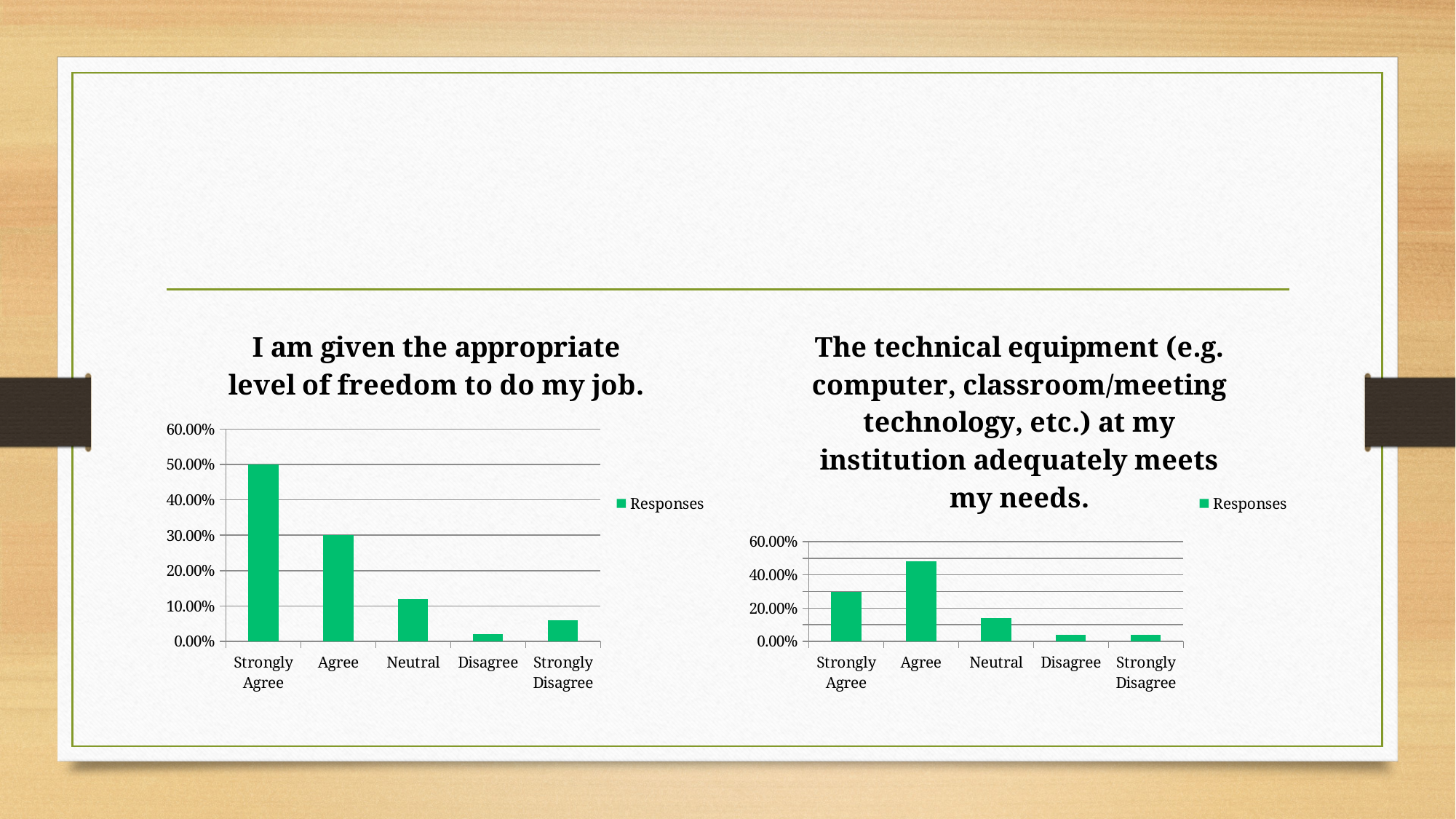
In the left chart, what is the difference between the Strongly Agree and Agree values? 20.00% In the left chart, which category has the lowest value? Disagree In the chart about technical equipment, is the value for Agree greater or less than 40.00%? greater How many categories are shown on the x axis of the left chart? 5 In the chart about technical equipment, which category has the highest value? Agree In the right chart, which is larger, the value for Strongly Agree or the value for Agree? Agree In the chart about technical equipment, is the value for Neutral greater or less than 20.00%? less In the chart titled "I am given the appropriate level of freedom to do my job.", what is the value for Strongly Agree? 50.00% In the chart titled "I am given the appropriate level of freedom to do my job.", what is the value for Agree? 30.00% In the left chart, is the value for Neutral greater or less than 20.00%? less In the left chart, which category has the highest value? Strongly Agree What type of chart is the chart about technical equipment? Bar chart